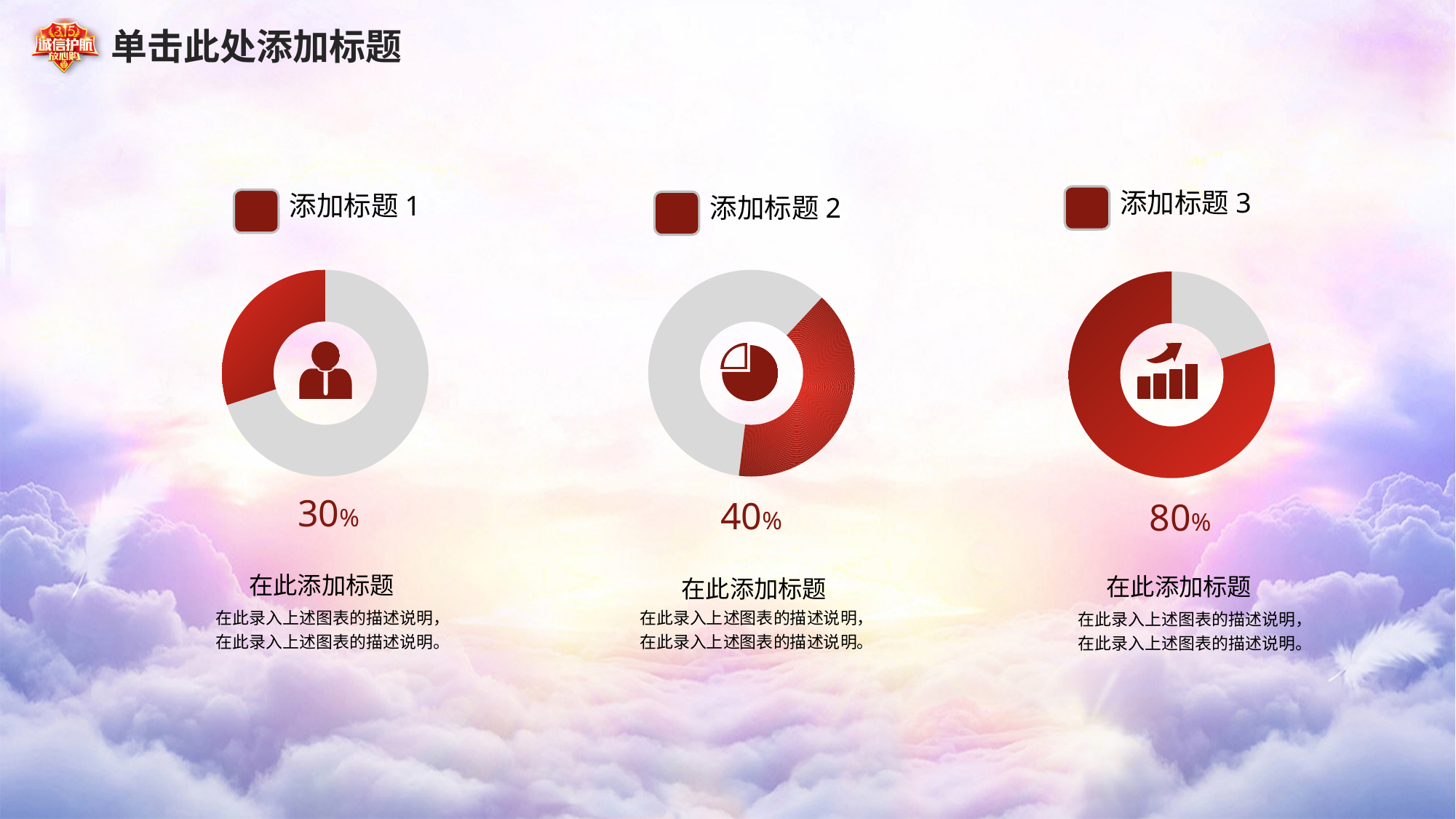
Do the percentages rise or fall reading the three charts from left to right? Rise How many donut charts are on the slide? 3 What value is shown below the donut chart under 添加标题 2? 40% What value is shown below the donut chart under 添加标题 1? 30% Which of the three donut charts shows the highest percentage? 添加标题 3 Which is larger, the percentage under 添加标题 2 or the percentage under 添加标题 3? 添加标题 3 What colour is the filled portion of each donut chart? Red What is the difference between the percentage under 添加标题 3 and the percentage under 添加标题 1? 50% Which of the three donut charts shows the lowest percentage? 添加标题 1 What value is shown below the donut chart under 添加标题 3? 80% What is the difference between the percentage under 添加标题 2 and the percentage under 添加标题 1? 10% What kind of chart is used under each of the three headings? Donut chart